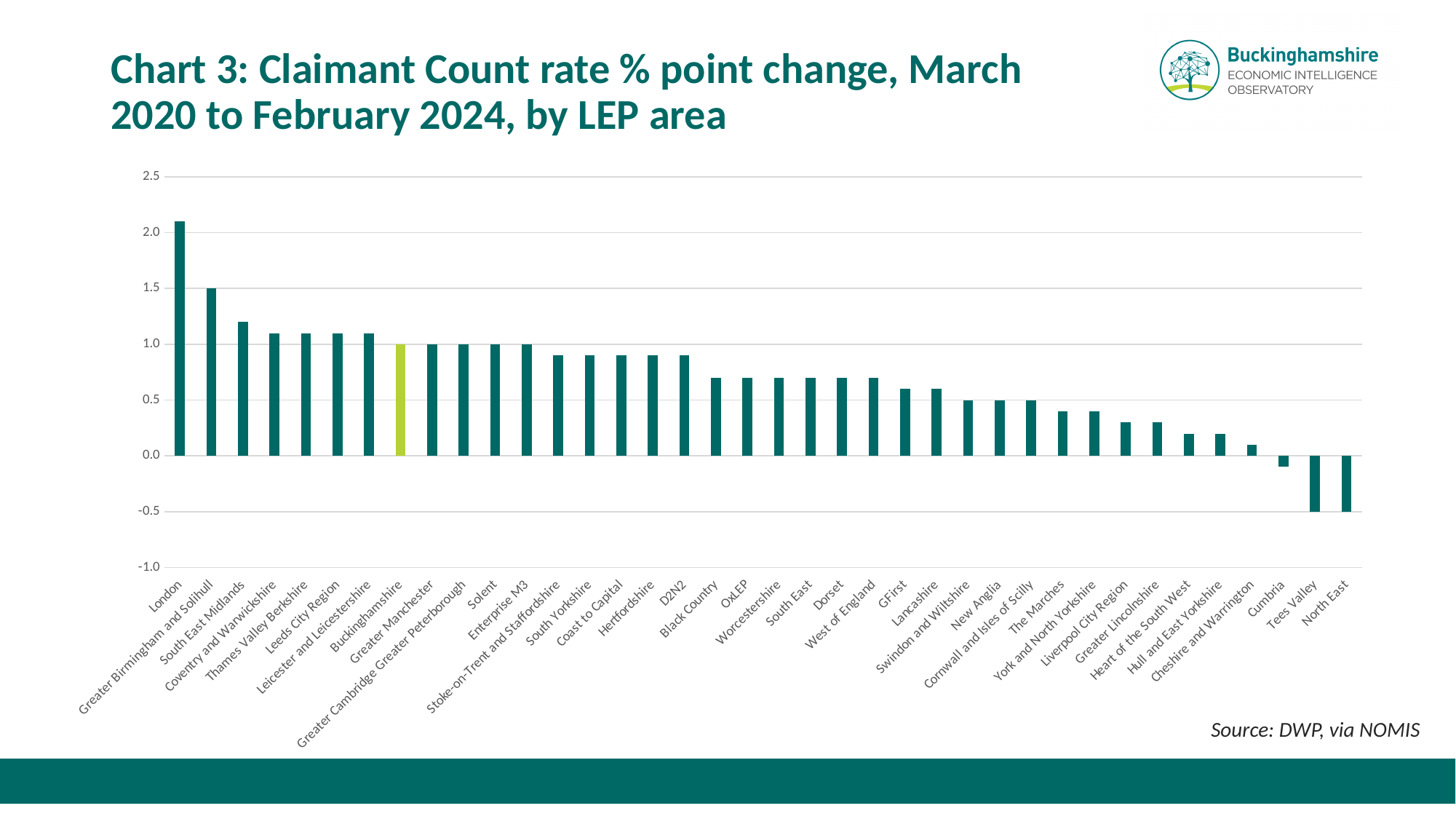
Is the value for South East Midlands greater or less than 1.0? greater Is the value for Black Country greater or less than 1.0? less What is the source cited for the chart? DWP, via NOMIS Is the value for Cumbria greater or less than 0.0? less Which LEP area has the highest Claimant Count rate % point change? London Which LEP area's bar is highlighted in a different colour from the rest? Buckinghamshire Which is larger, the value for Buckinghamshire or the value for Cumbria? Buckinghamshire Do the values rise or fall moving from left to right along the x axis? Fall What kind of chart is shown on the slide? Bar chart How many LEP areas are plotted on the chart? 38 Which is larger, the value for London or the value for Greater Birmingham and Solihull? London